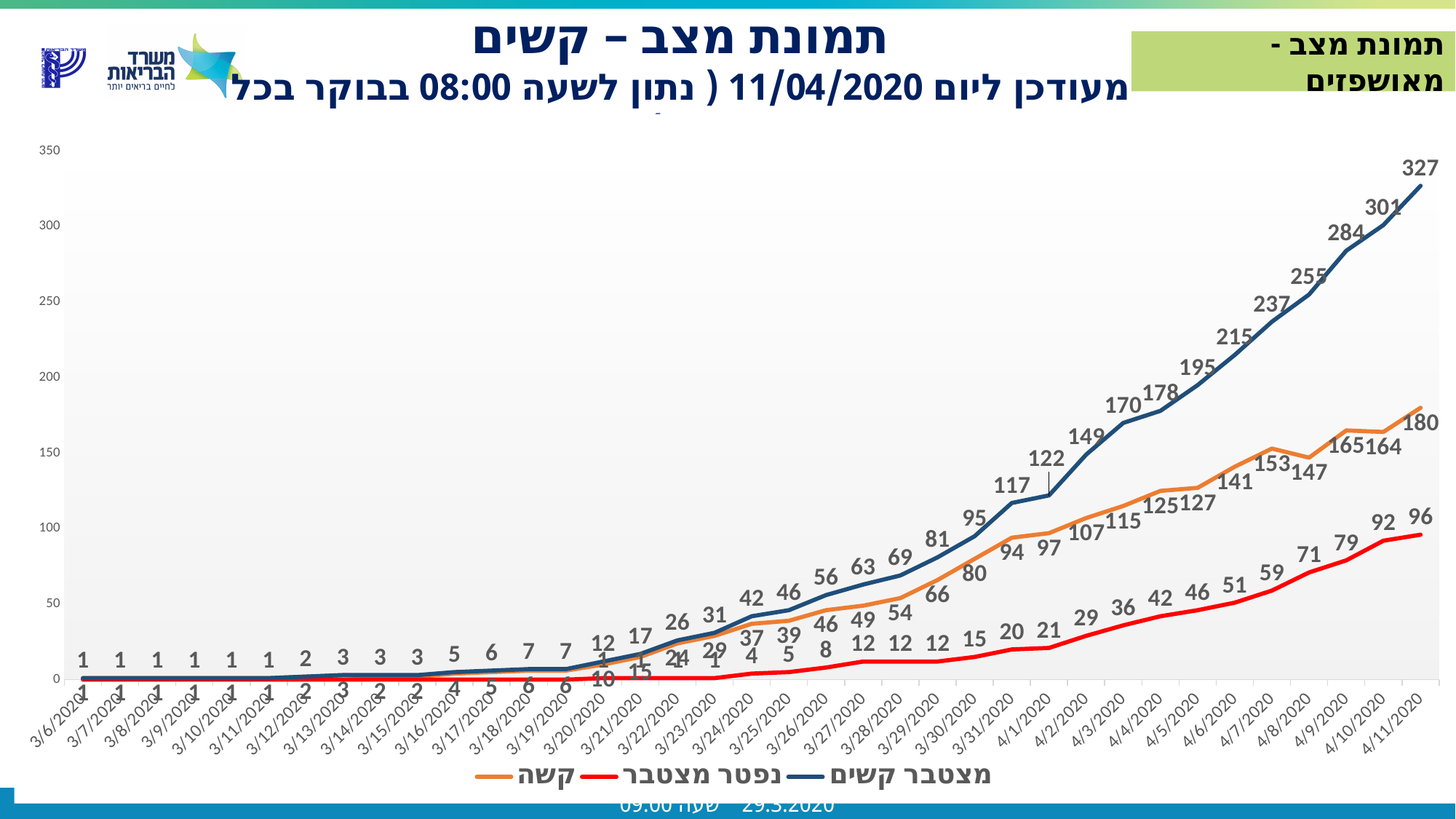
What is the value of the קשה series on 4/8/2020? 147 What kind of chart is shown on the slide? line chart Does the מצטבר קשים series rise or fall from 3/6/2020 to 4/11/2020? rise What is the value of the מצטבר קשים series on 4/1/2020? 122 What is the value of the מצטבר קשים series on 4/11/2020? 327 What is the value of the קשה series on 4/11/2020? 180 Which series has the larger value on 4/11/2020, קשה or נפטר מצטבר? קשה Is the value of the מצטבר קשים series on 4/5/2020 greater or less than 150? greater How many series does the legend list? 3 What is the value of the נפטר מצטבר series on 4/11/2020? 96 What is the difference between the מצטבר קשים values on 4/11/2020 and 4/10/2020? 26 On which date does the מצטבר קשים series reach its highest value? 4/11/2020